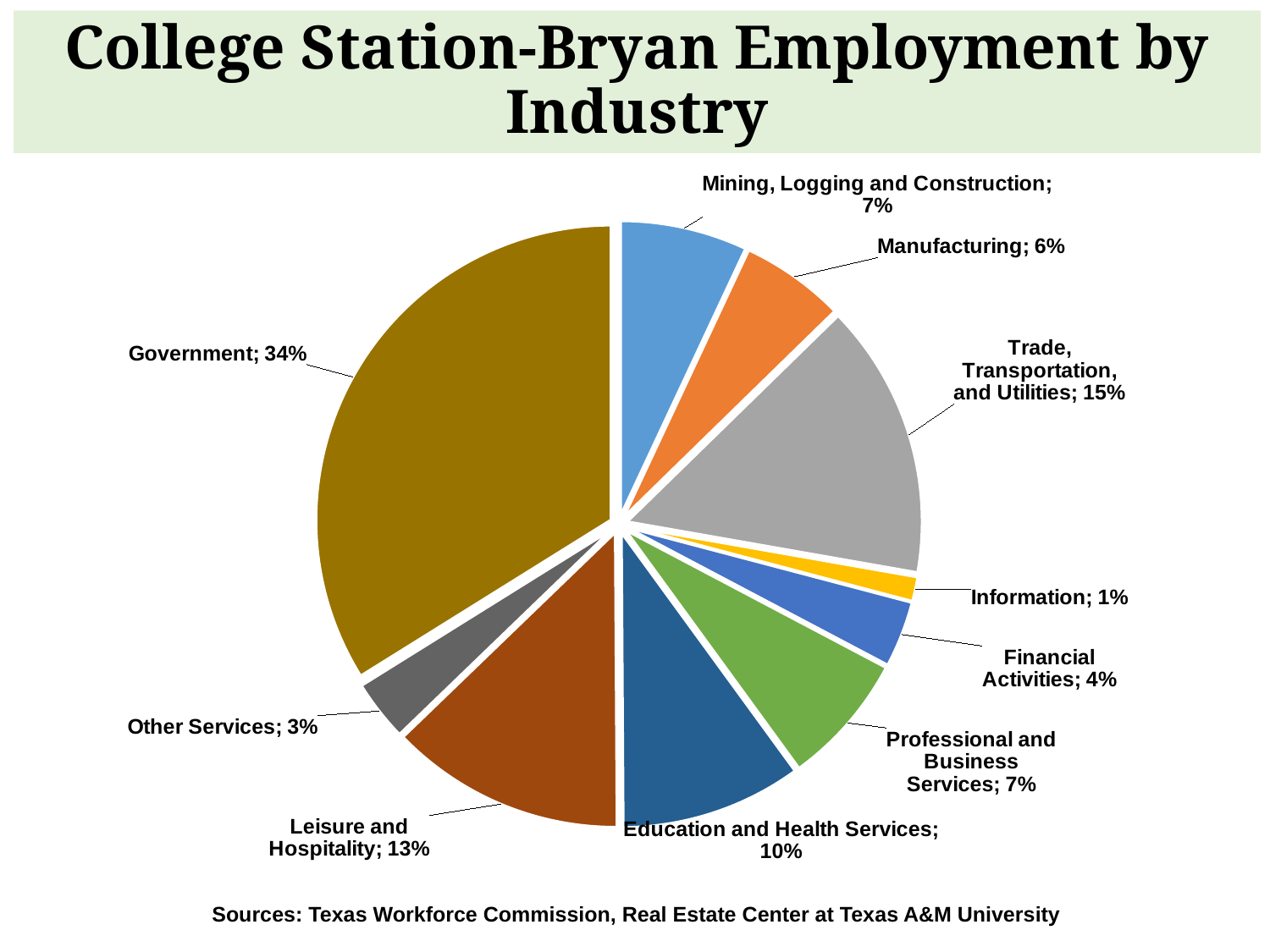
What is the difference in percentage points between Government and Leisure and Hospitality? 21 What share of employment is Information? 1% What share of employment is Education and Health Services? 10% Which is larger, Manufacturing or Financial Activities? Manufacturing What share of employment is Trade, Transportation, and Utilities? 15% How many industries are shown in the pie chart? 10 What type of chart is shown on the slide? Pie chart Which industry has the smallest share of employment? Information What is the title of the chart? College Station-Bryan Employment by Industry Which industry has the largest share of employment? Government What share of employment is Government? 34% What is the difference in percentage points between Trade, Transportation, and Utilities and Education and Health Services? 5